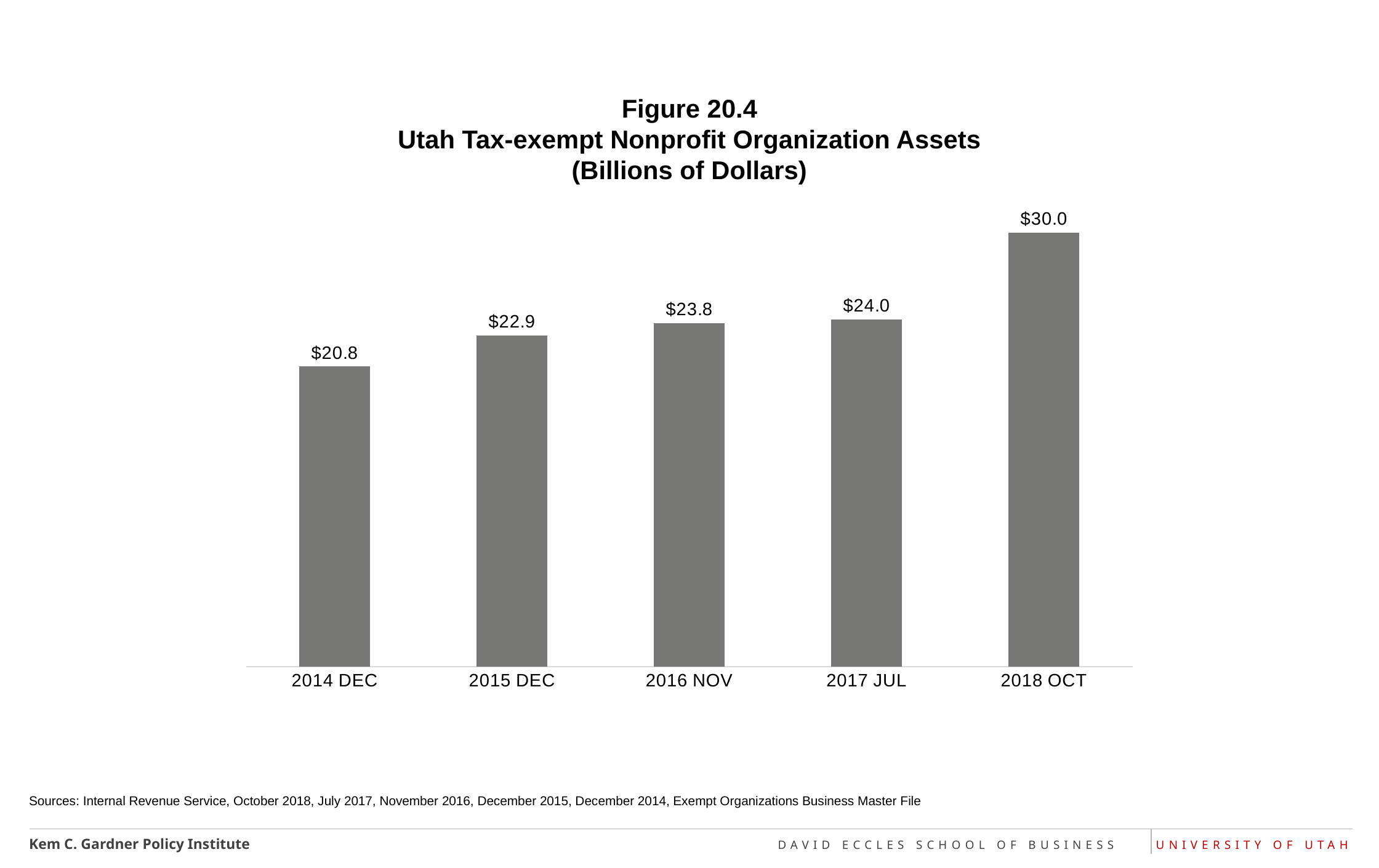
What is the value for 2018 OCT? $30.0 What is the value for 2014 DEC? $20.8 What unit are the values in, according to the chart title? Billions of Dollars Do the values rise or fall from 2014 DEC to 2018 OCT? Rise Which is larger, the value for 2015 DEC or the value for 2017 JUL? 2017 JUL What kind of chart is this? Bar chart How many periods are shown on the x axis? 5 Which period has the highest value? 2018 OCT Which period has the lowest value? 2014 DEC What is the difference between the values for 2015 DEC and 2014 DEC? $2.1 What is the difference between the values for 2018 OCT and 2017 JUL? $6.0 What is the value for 2016 NOV? $23.8